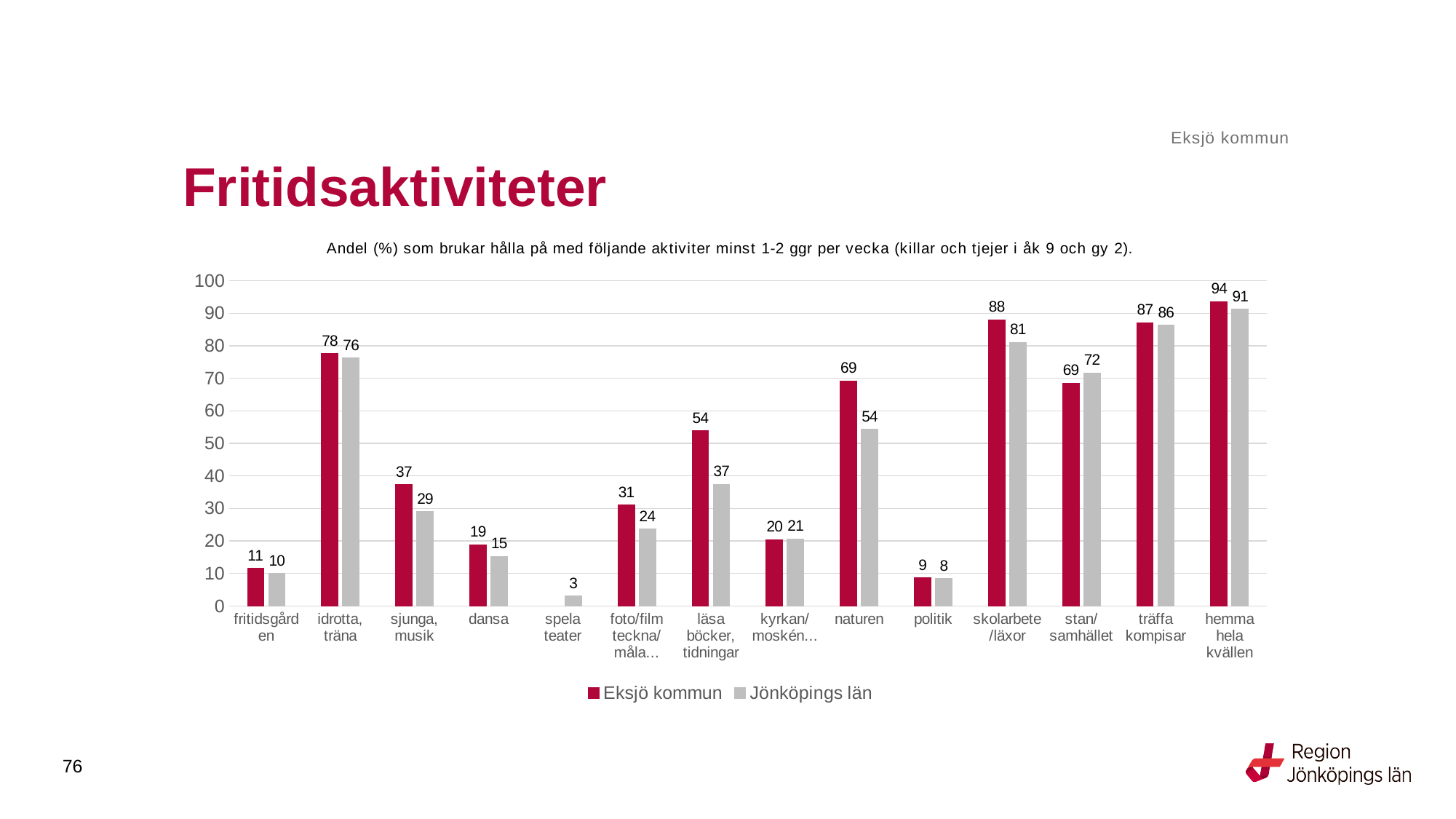
What is the value for Eksjö kommun for 'naturen'? 69 For 'sjunga, musik', which is larger: Eksjö kommun or Jönköpings län? Eksjö kommun What kind of chart is shown on the slide? bar chart Which series is shown in red? Eksjö kommun For 'stan/samhället', which is larger: Eksjö kommun or Jönköpings län? Jönköpings län What is the difference between Eksjö kommun and Jönköpings län for 'skolarbete/läxor'? 7 What is the value for Jönköpings län for 'läsa böcker, tidningar'? 37 Which activity has the lowest value for Jönköpings län? spela teater Which activity has the highest value for Eksjö kommun? hemma hela kvällen What is the value for Jönköpings län for 'dansa'? 15 How many series does the legend list? 2 How many activity categories are shown on the x axis? 14